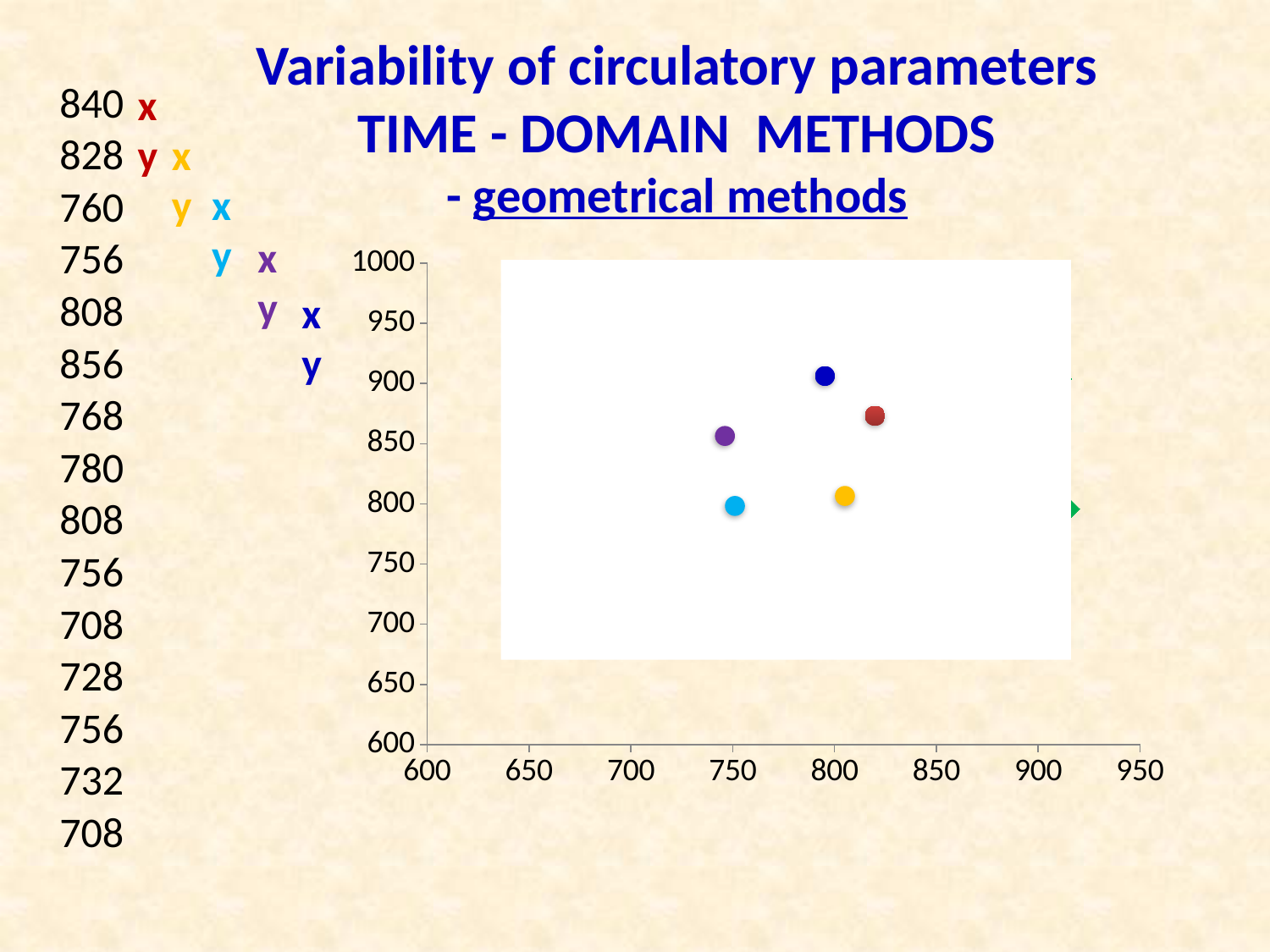
How many round data points are plotted in the scatter chart? 5 Is the horizontal-axis value of the red point greater or less than 800? greater Which point is further to the right on the horizontal axis, the red point or the purple point? the red point Which point in the scatter chart has the highest value on the vertical axis? the dark blue point What is the range of the horizontal axis of the scatter chart? 600 to 950 Is the vertical-axis value of the light blue point greater or less than 850? less Is the vertical-axis value of the dark blue point greater or less than 850? greater Which point is higher on the vertical axis, the dark blue point or the red point? the dark blue point What kind of chart is shown on the slide? scatter chart